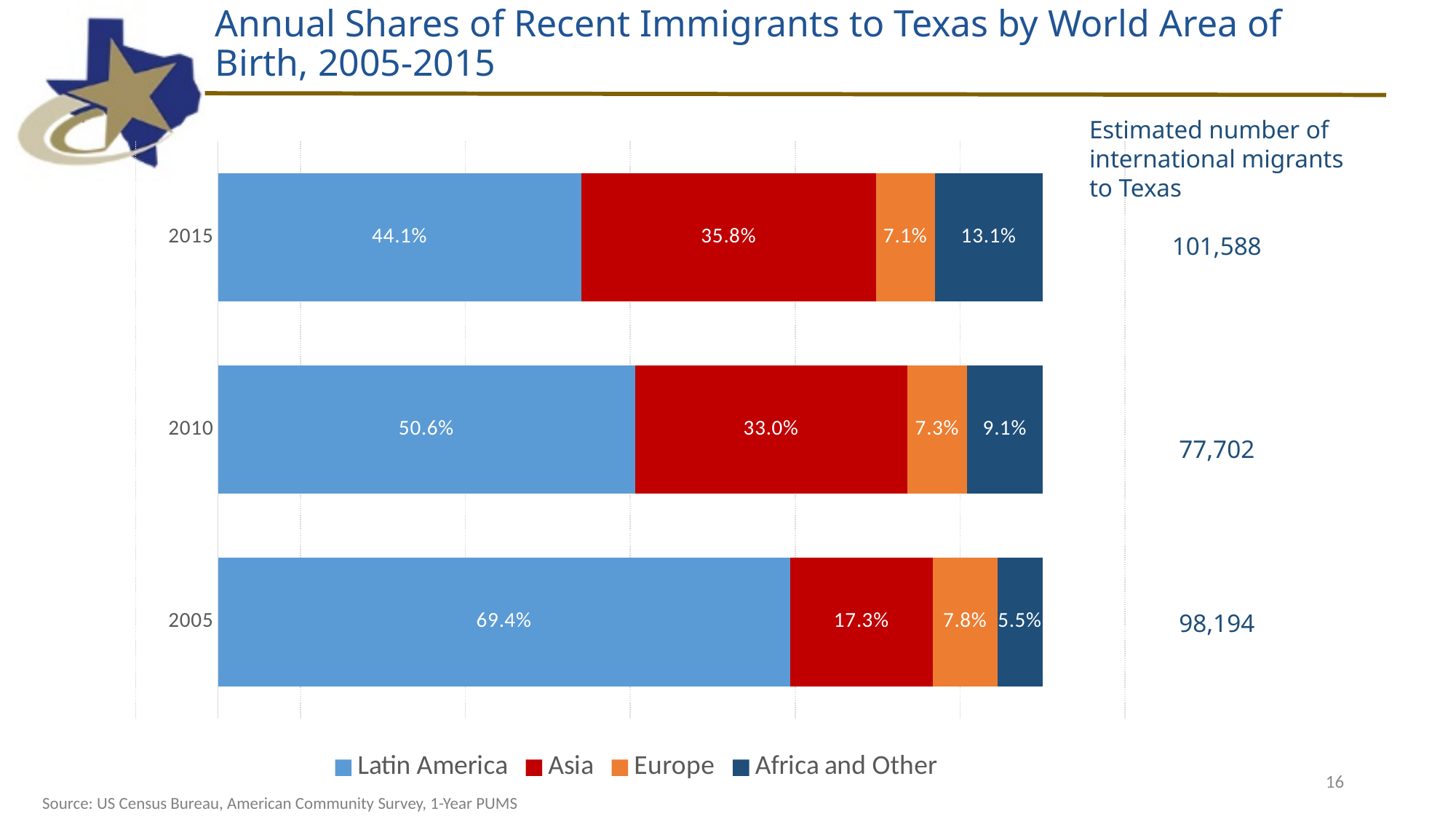
By how many percentage points did the Latin America share fall from 2005 to 2015? 25.3 percentage points Which was larger in 2010, the Asia share or the Africa and Other share? Asia What share of recent immigrants to Texas in 2015 were born in Africa and Other? 13.1% What share of recent immigrants to Texas in 2015 were born in Latin America? 44.1% How many series does the legend list? 4 In which year was the Latin America share of recent immigrants to Texas highest? 2005 What share of recent immigrants to Texas in 2005 were born in Asia? 17.3% What share of recent immigrants to Texas in 2010 were born in Europe? 7.3% How does the Asia share of recent immigrants to Texas change from 2005 to 2015? It rises How many years are shown in the chart? 3 In which year was the Asia share of recent immigrants to Texas lowest? 2005 What type of chart is shown on the slide? Stacked bar chart